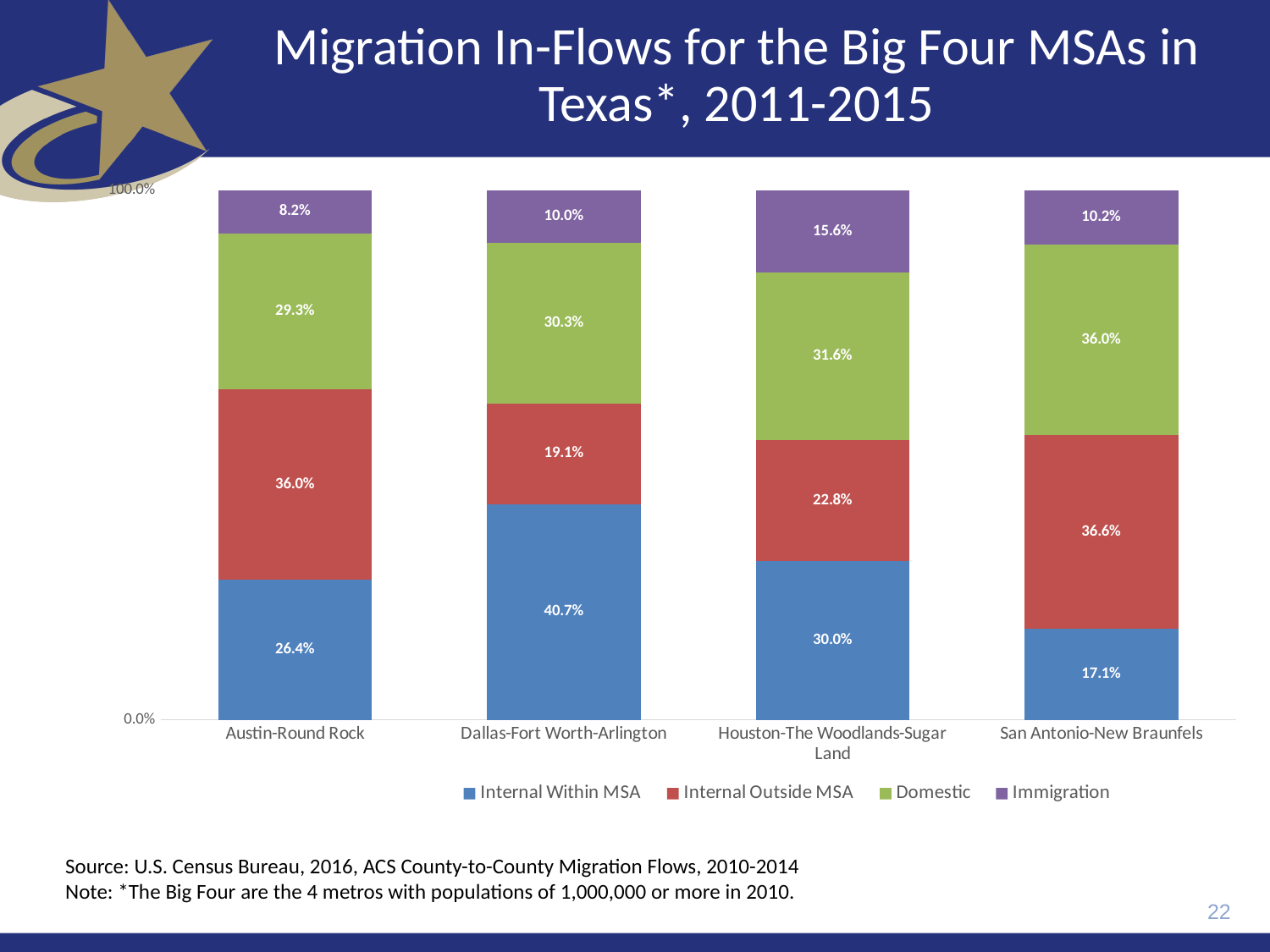
What is the Immigration share for Houston-The Woodlands-Sugar Land? 15.6% What is the Internal Within MSA share for Dallas-Fort Worth-Arlington? 40.7% What kind of chart is shown on the slide? Stacked bar chart Which MSA has the lowest Immigration share? Austin-Round Rock Which is larger, the Internal Outside MSA share for Austin-Round Rock or for San Antonio-New Braunfels? San Antonio-New Braunfels Which MSA has the highest Internal Within MSA share? Dallas-Fort Worth-Arlington What is the Domestic share for Dallas-Fort Worth-Arlington? 30.3% How many series does the legend list? 4 Which MSA has the highest Immigration share? Houston-The Woodlands-Sugar Land What is the difference between the Domestic share for San Antonio-New Braunfels and for Austin-Round Rock? 6.7 percentage points What is the Internal Outside MSA share for San Antonio-New Braunfels? 36.6% How many MSAs are shown on the x axis? 4